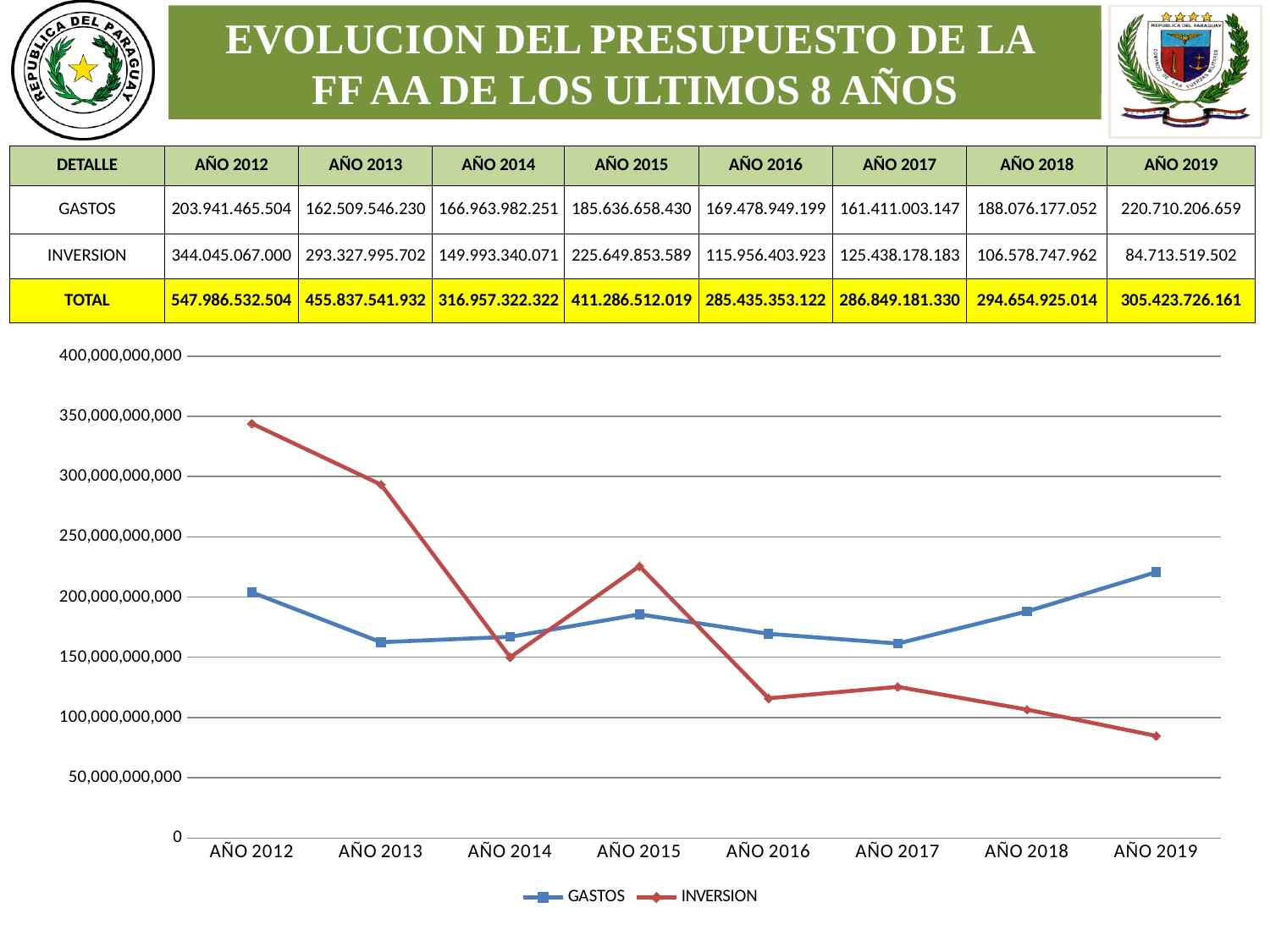
What is the difference between GASTOS in AÑO 2019 and GASTOS in AÑO 2012? 16.768.741.155 How many years are plotted on the x axis of the chart? 8 In which year is the INVERSION series highest? AÑO 2012 In which year is the GASTOS series highest? AÑO 2019 What is the INVERSION value for AÑO 2014? 149.993.340.071 In AÑO 2015, which series has the larger value, GASTOS or INVERSION? INVERSION How many series does the chart legend list? 2 What is the TOTAL for AÑO 2012? 547.986.532.504 What kind of chart is shown on the slide? line chart What is the GASTOS value for AÑO 2019? 220.710.206.659 In which year is the INVERSION series lowest? AÑO 2019 Is the INVERSION value for AÑO 2016 greater or less than 150,000,000,000? less